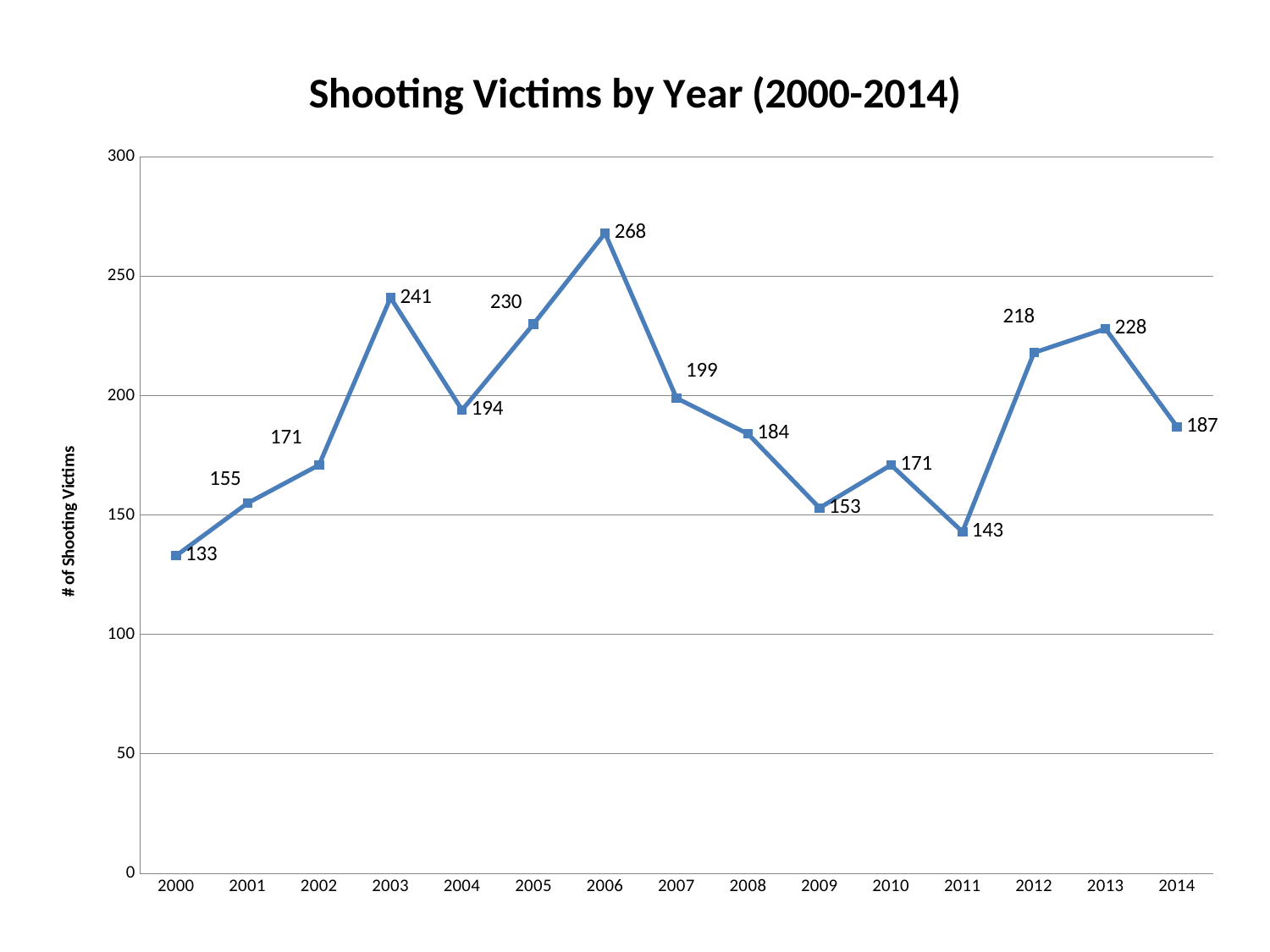
Which year had the highest number of shooting victims? 2006 Do the values rise or fall from 2006 to 2009? fall Which year had more shooting victims, 2003 or 2005? 2003 Is the value for 2007 greater or less than 150? greater What is the difference in shooting victims between 2006 and 2000? 135 How many years are plotted on the chart? 15 What is the difference in shooting victims between 2013 and 2012? 10 What is the number of shooting victims for 2011? 143 How many shooting victims were there in 2006? 268 What is the title of the chart? Shooting Victims by Year (2000-2014) What type of chart is shown on the slide? line chart Which year had the lowest number of shooting victims? 2000